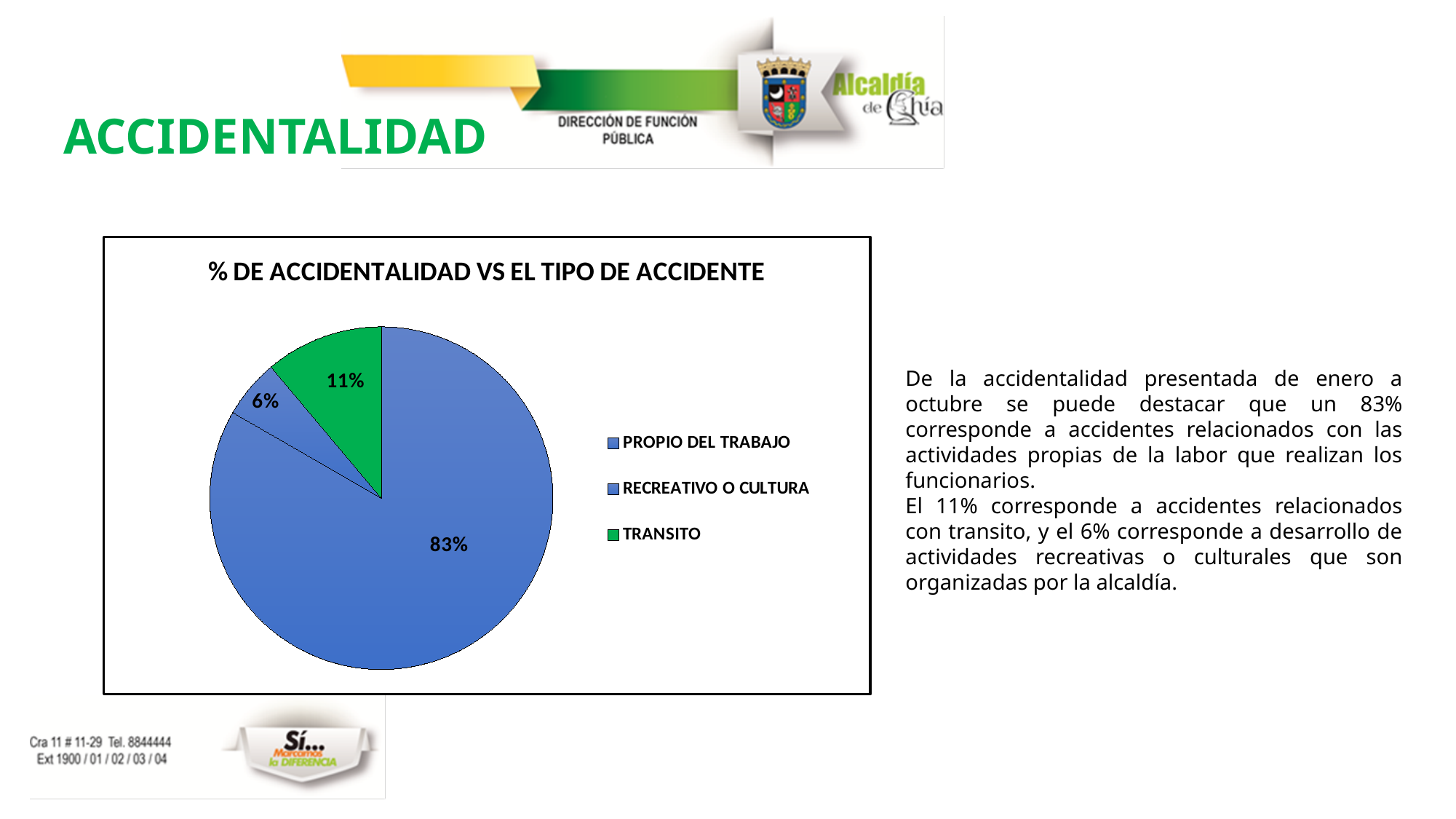
What is the difference in percentage points between PROPIO DEL TRABAJO and TRANSITO? 72 Which type of accident has the smallest share of the pie? RECREATIVO O CULTURA What percentage of accidents corresponds to RECREATIVO O CULTURA? 6% What percentage of accidents corresponds to PROPIO DEL TRABAJO? 83% What percentage of accidents corresponds to TRANSITO? 11% How many categories does the pie chart show? 3 Which is larger, the share for TRANSITO or the share for RECREATIVO O CULTURA? TRANSITO What is the title of the chart? % DE ACCIDENTALIDAD VS EL TIPO DE ACCIDENTE What kind of chart is shown on the slide? pie chart Which category is shown in green in the pie chart? TRANSITO Which type of accident has the largest share of the pie? PROPIO DEL TRABAJO What is the difference in percentage points between TRANSITO and RECREATIVO O CULTURA? 5